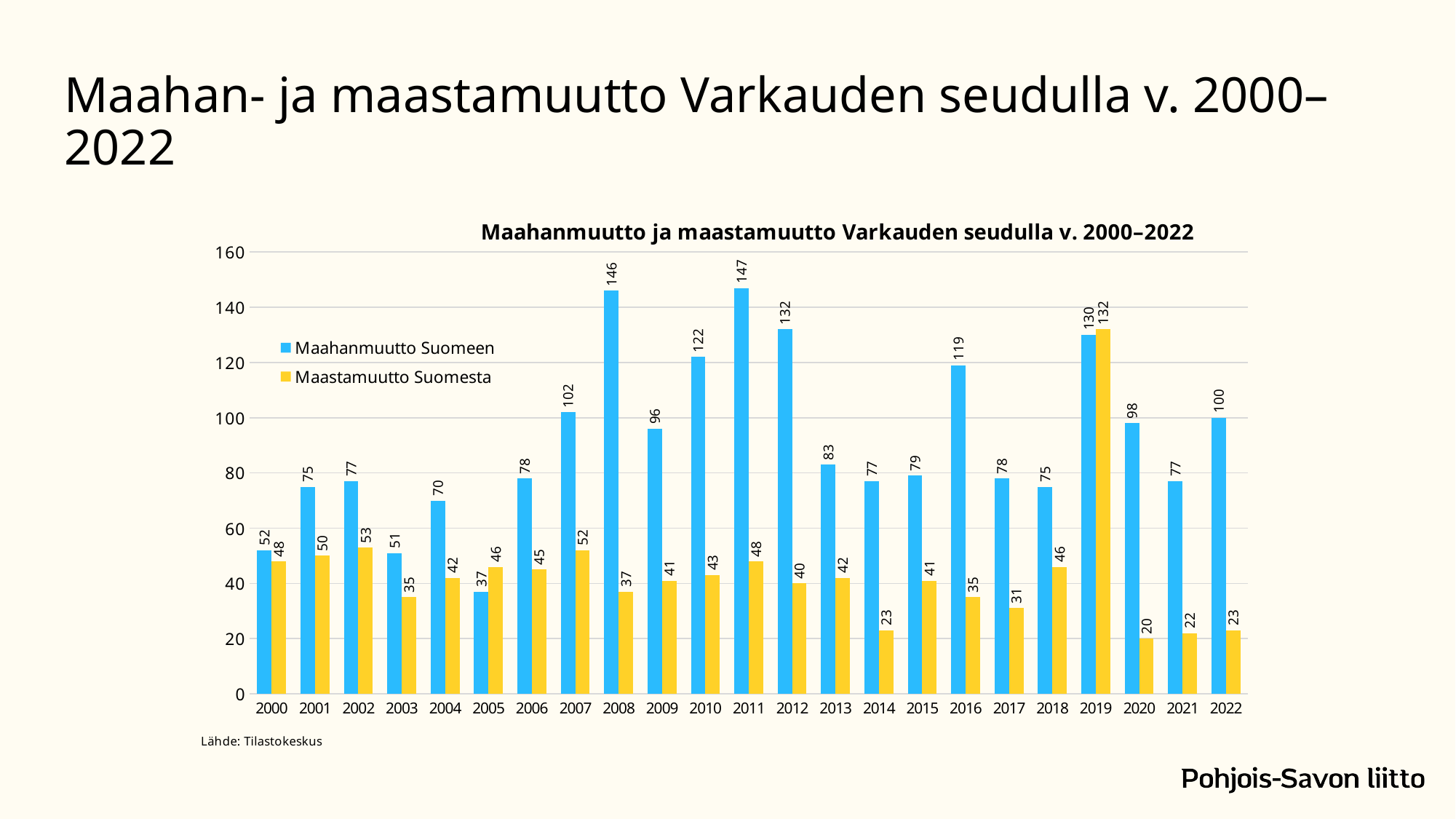
Is the value of Maahanmuutto Suomeen in 2016 greater or less than 100? greater What is the value of Maahanmuutto Suomeen in 2008? 146 How many years are shown on the x axis? 23 In which year is Maahanmuutto Suomeen highest? 2011 In which year is Maastamuutto Suomesta lowest? 2020 Which colour represents Maastamuutto Suomesta in the chart? Yellow What kind of chart is shown on the slide? Bar chart Which is larger in 2019, Maahanmuutto Suomeen or Maastamuutto Suomesta? Maastamuutto Suomesta What is the difference between Maahanmuutto Suomeen and Maastamuutto Suomesta in 2011? 99 How many series does the legend list? 2 What is the value of Maastamuutto Suomesta in 2019? 132 In which year is Maahanmuutto Suomeen lowest? 2005